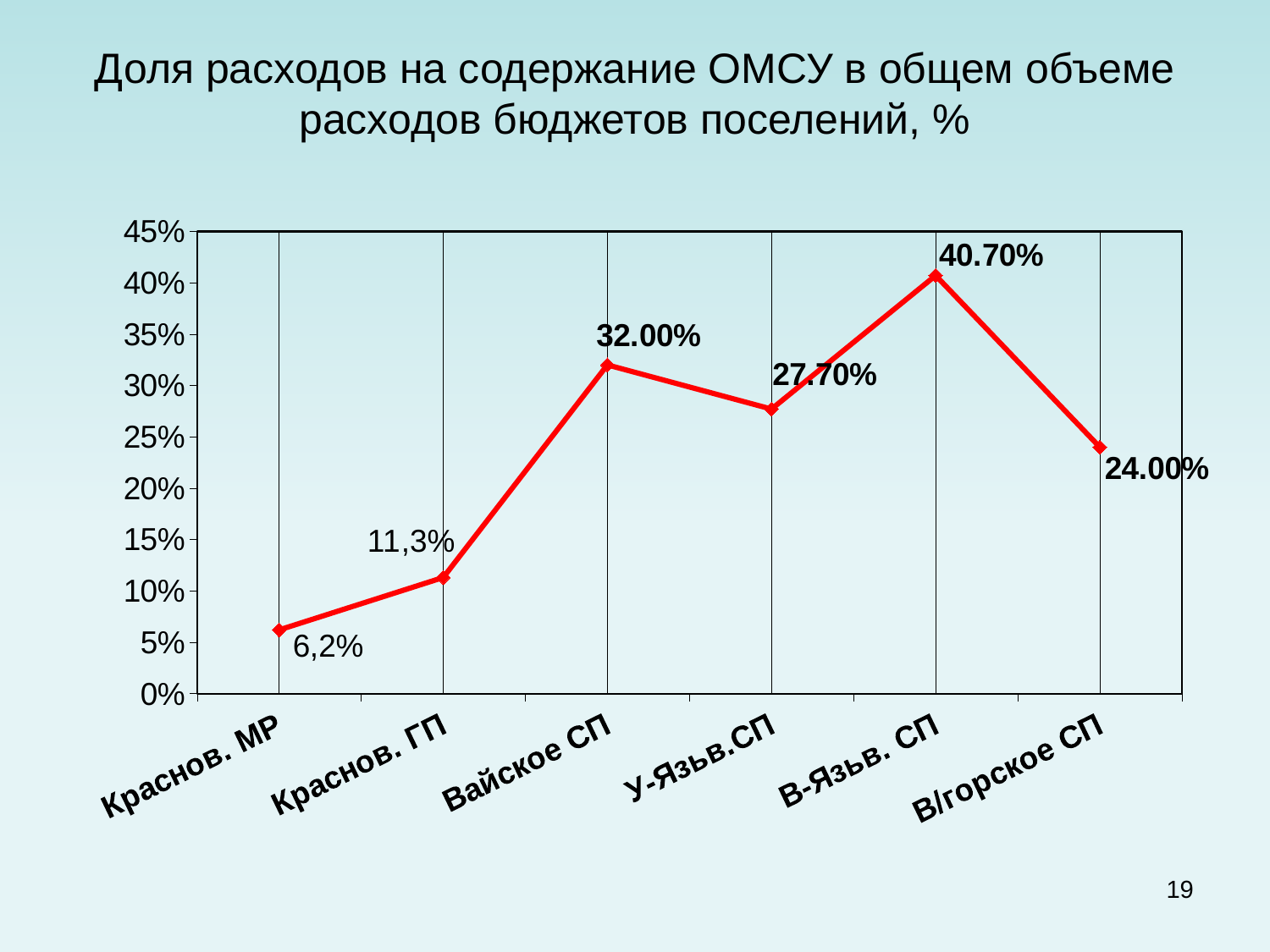
What is the value for В-Язьв. СП? 40.70% What is the value for Краснов. МР? 6,2% How many categories are plotted on the x axis? 6 Which category has the highest value? В-Язьв. СП What is the value for В/горское СП? 24.00% Is the value for Краснов. ГП greater or less than 15%? less Which is larger, the value for У-Язьв.СП or the value for В/горское СП? У-Язьв.СП What is the difference between the values for Вайское СП and У-Язьв.СП? 4.30 percentage points What is the difference between the values for В-Язьв. СП and Вайское СП? 8.70 percentage points What is the value for Вайское СП? 32.00% What type of chart is shown on the slide? line chart Which category has the lowest value? Краснов. МР